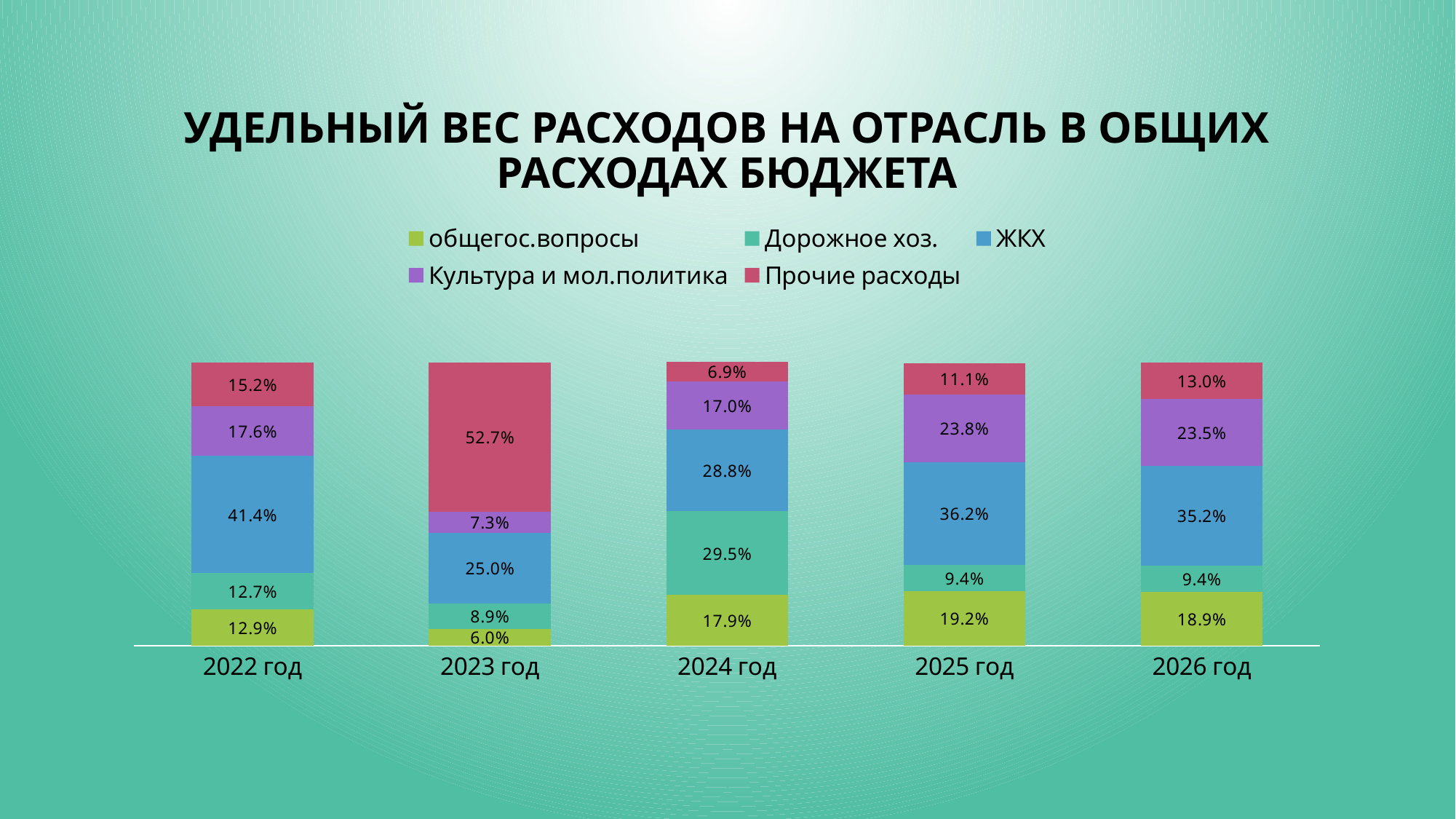
In which year is the share of Прочие расходы the highest? 2023 год What share does ЖКХ have in 2022 год? 41.4% What is the value for Дорожное хоз. in 2024 год? 29.5% Which is larger in 2024 год: Дорожное хоз. or ЖКХ? Дорожное хоз. What is the difference between the ЖКХ share in 2025 год and in 2026 год? 1.0% How many years are shown on the x axis? 5 In which year is the share of общегос.вопросы the lowest? 2023 год How many series does the legend list? 5 What kind of chart is shown on the slide? Stacked bar chart Which colour represents Прочие расходы in the legend? Red What is the value for Прочие расходы in 2023 год? 52.7% What is the value for Культура и мол.политика in 2025 год? 23.8%